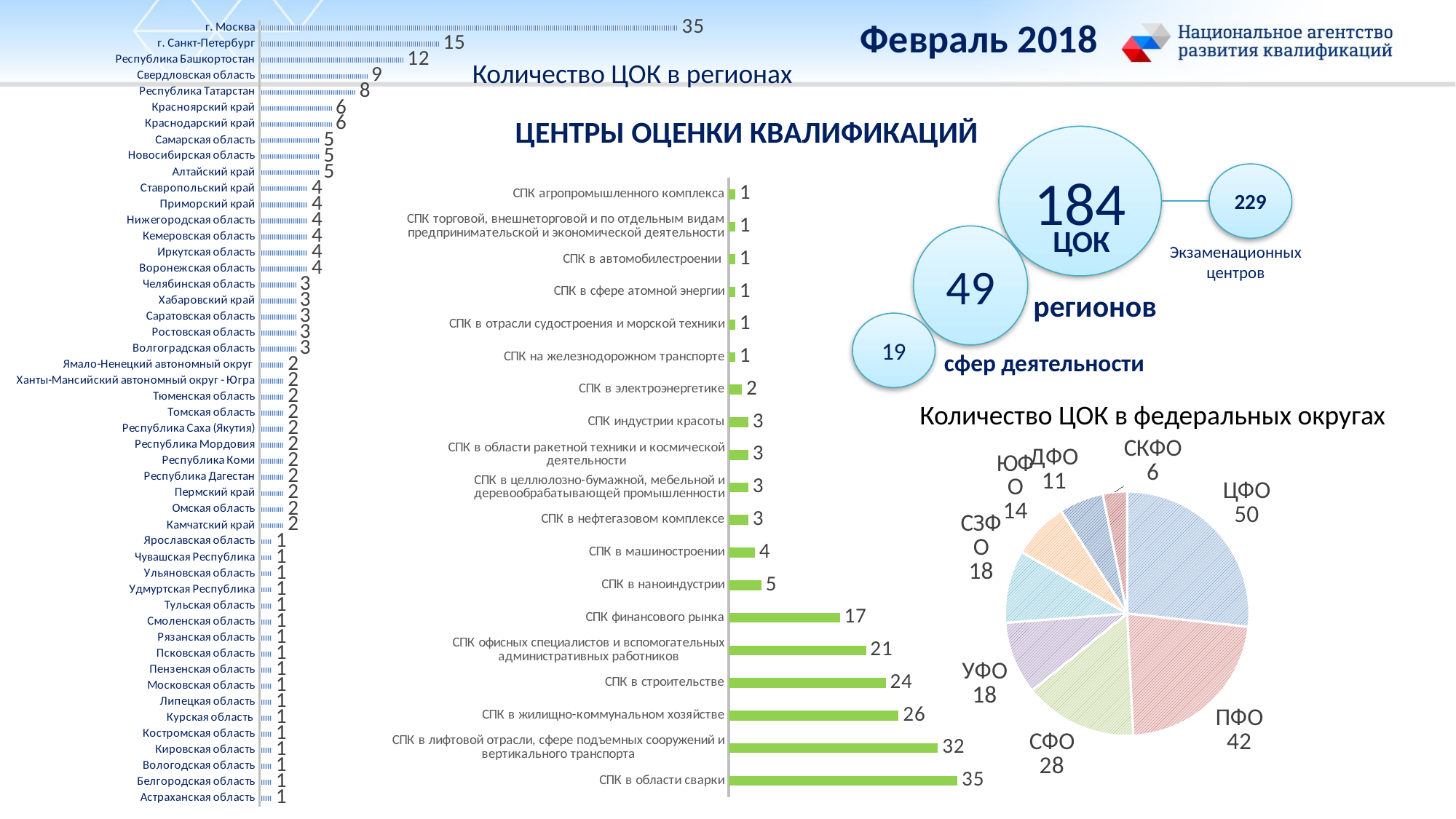
In the chart 'Количество ЦОК в регионах', how many regions are listed? 49 In the pie chart 'Количество ЦОК в федеральных округах', what is the value for ПФО? 42 In the chart 'Количество ЦОК в регионах', what is the difference between г. Санкт-Петербург and Республика Башкортостан? 3 In the middle bar chart under 'ЦЕНТРЫ ОЦЕНКИ КВАЛИФИКАЦИЙ', what is the value for СПК финансового рынка? 17 In the chart 'Количество ЦОК в регионах', what is the value for г. Москва? 35 What type of chart is 'Количество ЦОК в федеральных округах'? pie chart In the pie chart 'Количество ЦОК в федеральных округах', which federal district has the smallest value? СКФО In the middle bar chart under 'ЦЕНТРЫ ОЦЕНКИ КВАЛИФИКАЦИЙ', which is larger: СПК в строительстве or СПК в жилищно-коммунальном хозяйстве? СПК в жилищно-коммунальном хозяйстве In the chart 'Количество ЦОК в регионах', which region has the highest value? г. Москва In the pie chart 'Количество ЦОК в федеральных округах', what is the difference between ЦФО and СФО? 22 In the middle bar chart under 'ЦЕНТРЫ ОЦЕНКИ КВАЛИФИКАЦИЙ', how many categories are shown? 19 In the middle bar chart under 'ЦЕНТРЫ ОЦЕНКИ КВАЛИФИКАЦИЙ', what is the value for СПК в области сварки? 35